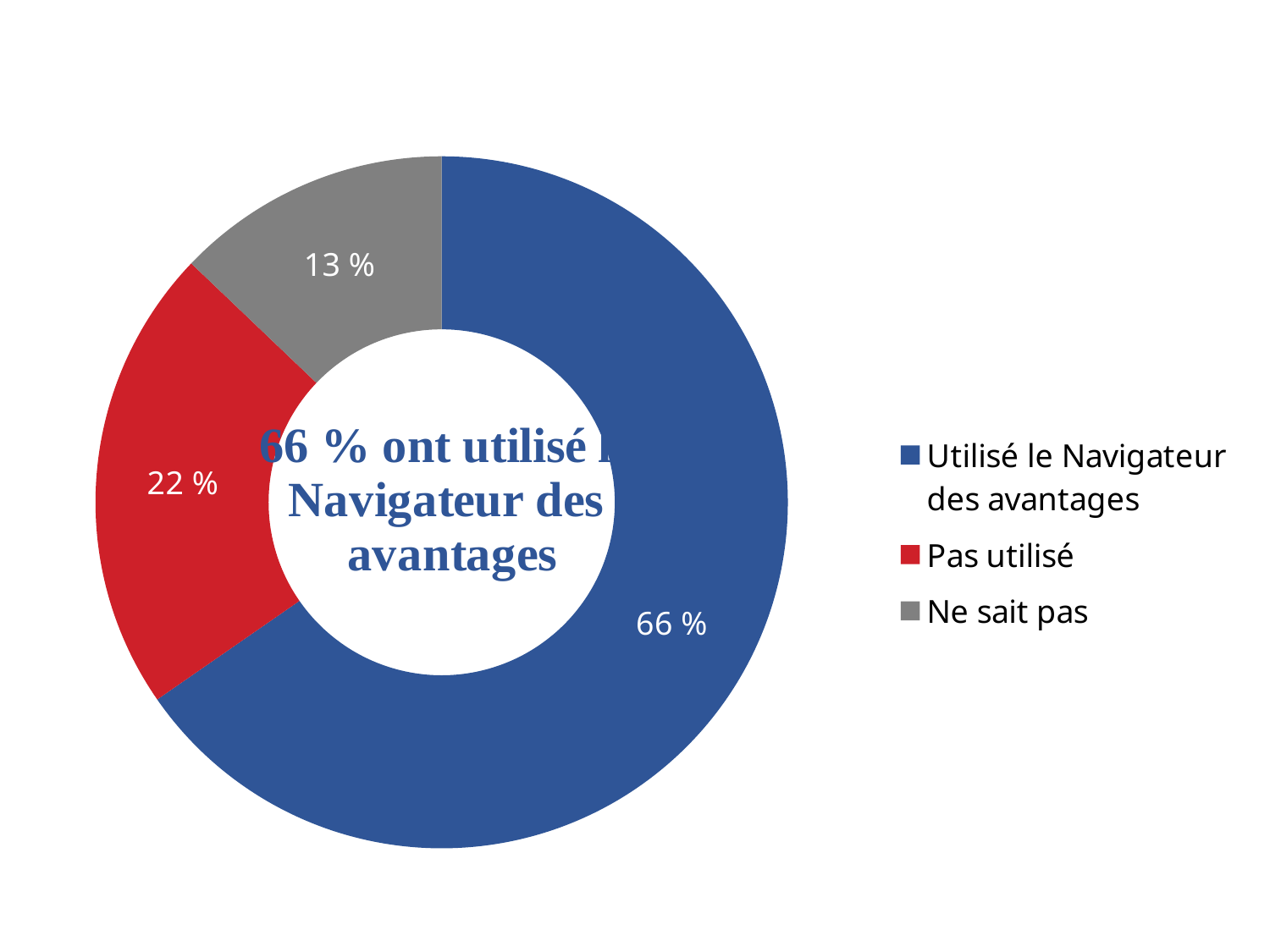
What share of the pie does "Utilisé le Navigateur des avantages" represent? 66 % What is the value shown for "Pas utilisé"? 22 % Which is larger, "Pas utilisé" or "Ne sait pas"? Pas utilisé What kind of chart is shown on the slide? Pie chart (doughnut) What is the difference between the "Pas utilisé" and "Ne sait pas" values? 9 % How many categories does the chart show? 3 Which category has the largest slice? Utilisé le Navigateur des avantages What colour is the "Pas utilisé" slice? Red Which category has the smallest slice? Ne sait pas What is the difference between the "Utilisé le Navigateur des avantages" and "Pas utilisé" values? 44 % What is the value shown for "Ne sait pas"? 13 % What text is written in the centre of the chart? 66 % ont utilisé le Navigateur des avantages